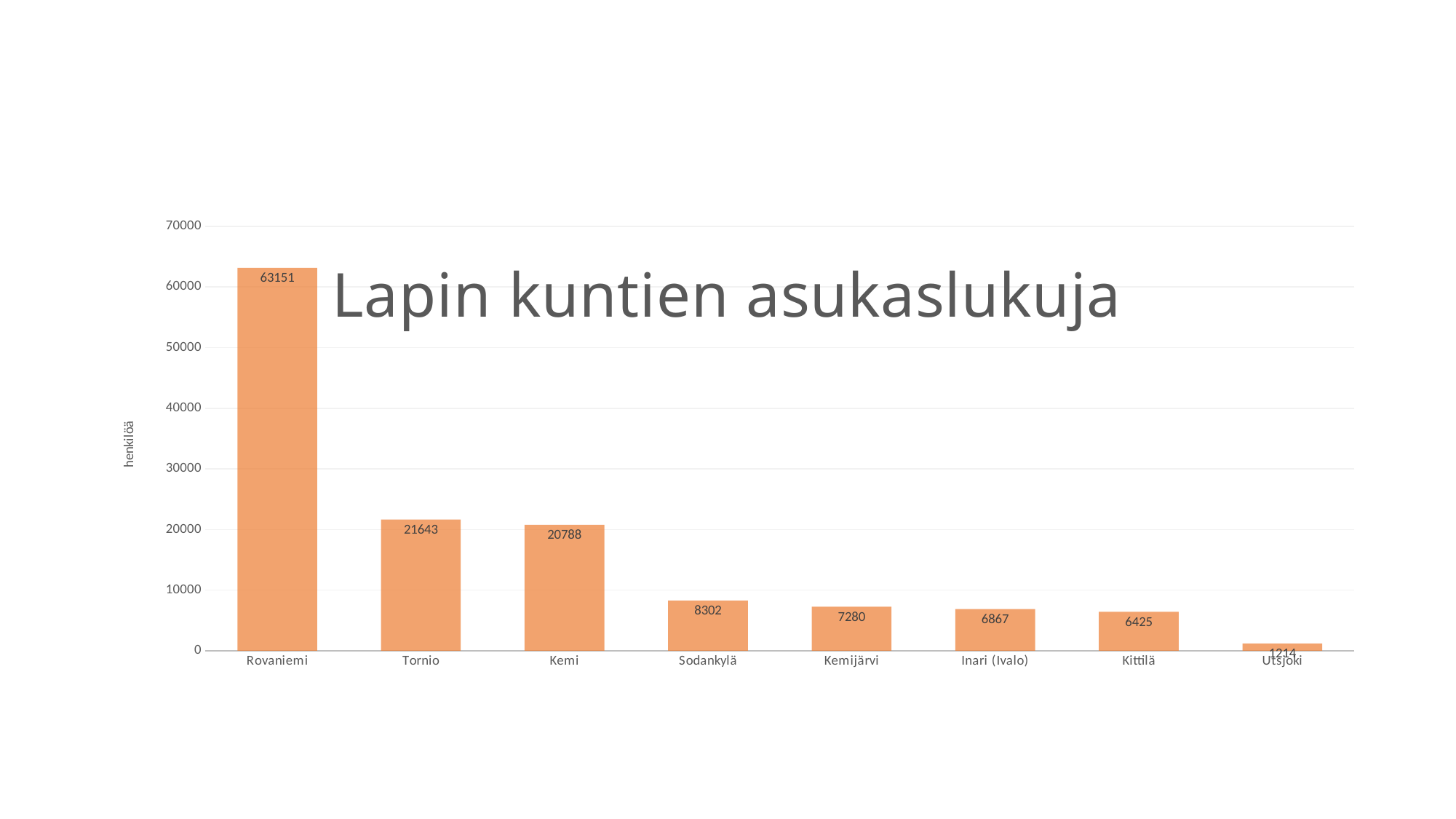
What is the value for Kittilä? 6425 What is the label on the vertical axis? henkilöä What is the value for Sodankylä? 8302 What is the value for Rovaniemi? 63151 What is the difference between the values for Rovaniemi and Utsjoki? 61937 Which municipality has the lowest value? Utsjoki How many municipalities are shown on the chart? 8 Which municipality has the highest value? Rovaniemi What is the difference between the values for Tornio and Kemi? 855 What kind of chart is shown on the slide? bar chart Which is larger, the value for Kemijärvi or the value for Inari (Ivalo)? Kemijärvi Is the value for Tornio greater or less than 20000? greater